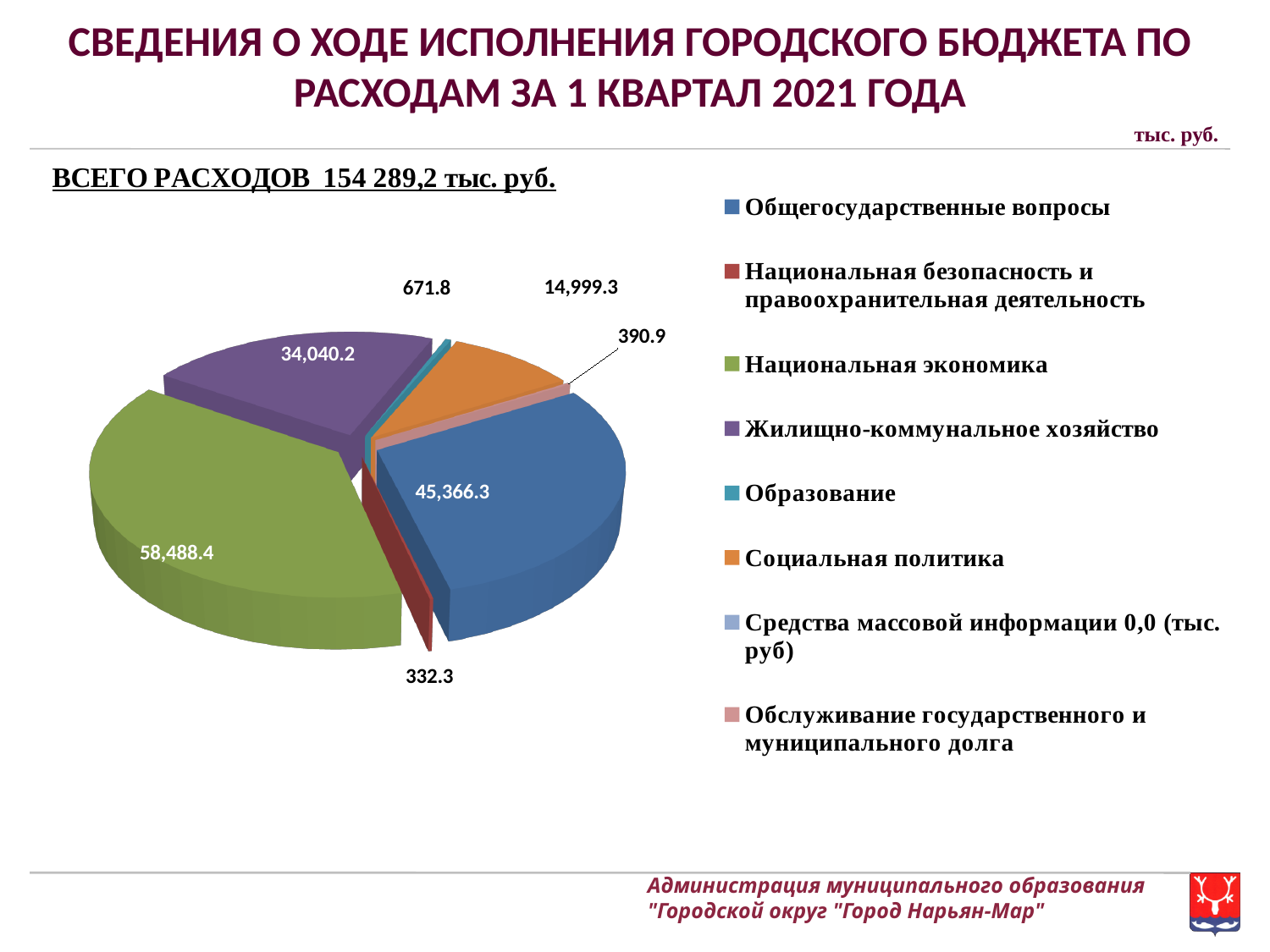
What is the value for Жилищно-коммунальное хозяйство? 34,040.2 Which category has the largest slice of the pie? Национальная экономика What type of chart is shown on the slide? pie chart What is the value for Общегосударственные вопросы? 45,366.3 How many entries does the legend list? 8 What is the value for Социальная политика? 14,999.3 What is the value for Национальная экономика? 58,488.4 What is the difference between Национальная экономика and Общегосударственные вопросы? 13,122.1 What is the value for Обслуживание государственного и муниципального долга? 390.9 What total expenditure (ВСЕГО РАСХОДОВ) is stated on the slide? 154 289,2 тыс. руб. Which is larger, Общегосударственные вопросы or Жилищно-коммунальное хозяйство? Общегосударственные вопросы What is the value for Образование? 671.8